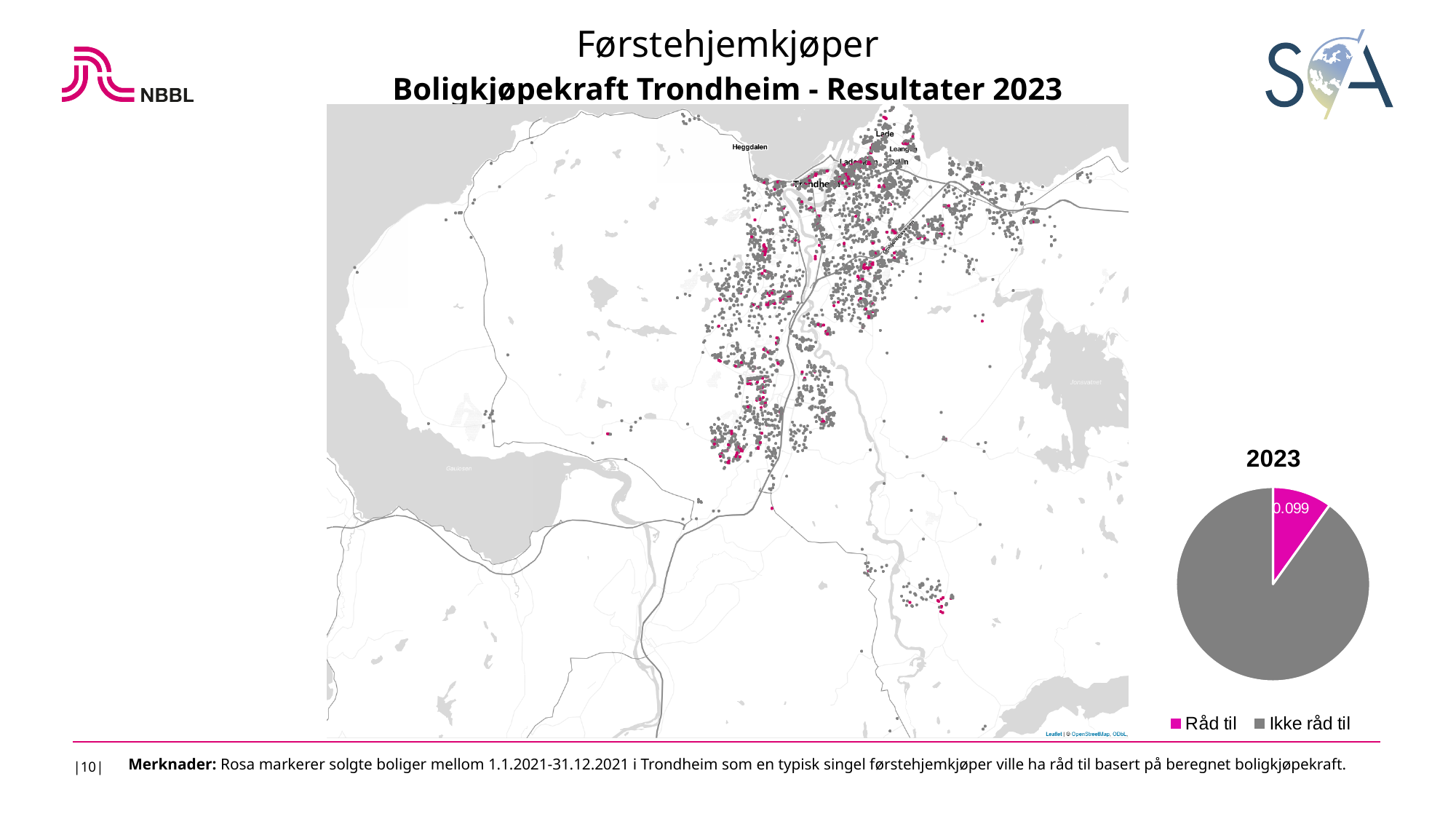
In the pie chart, which category has the smallest slice? Råd til How many entries does the legend of the pie chart list? 2 In the pie chart, which category has the largest slice? Ikke råd til What kind of chart is shown on the right side of the slide under the heading 2023? pie chart In the pie chart, which slice is larger: Råd til or Ikke råd til? Ikke råd til How many slices does the pie chart have? 2 In the pie chart, what value is printed on the Råd til slice? 0.099 What is the title shown above the pie chart? 2023 What share of the pie chart does the Råd til slice represent, as labelled? 0.099 In the pie chart, which colour represents Råd til? pink